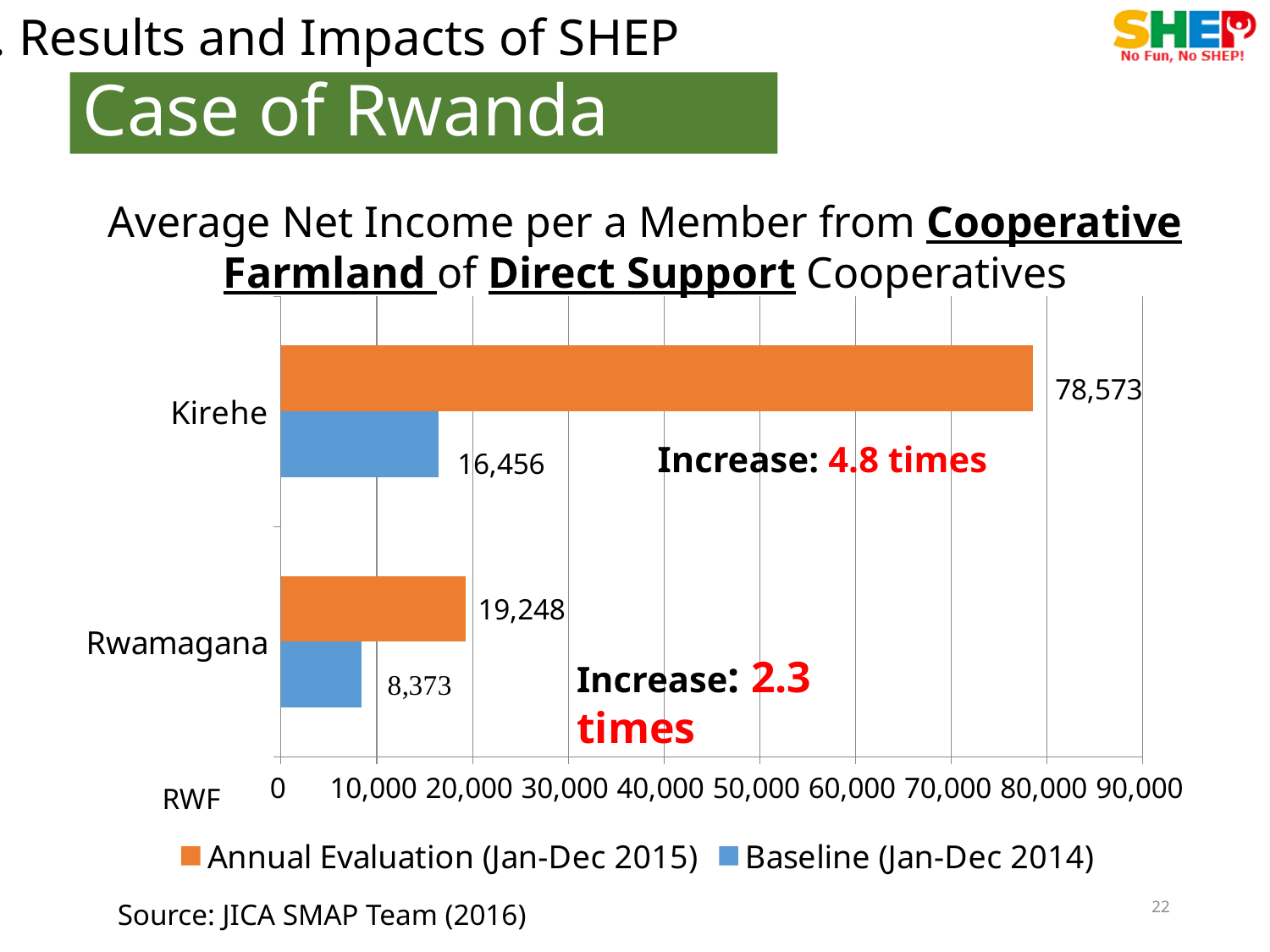
What kind of chart is shown on the slide? Bar chart What is the Annual Evaluation (Jan-Dec 2015) value for Rwamagana? 19,248 What is the Annual Evaluation (Jan-Dec 2015) value for Kirehe? 78,573 How many series does the legend list? 2 Which is larger: the Baseline (Jan-Dec 2014) value for Kirehe or the Annual Evaluation (Jan-Dec 2015) value for Rwamagana? Annual Evaluation (Jan-Dec 2015) value for Rwamagana How many categories are shown on the chart? 2 What is the Baseline (Jan-Dec 2014) value for Rwamagana? 8,373 What is the difference between the Annual Evaluation (Jan-Dec 2015) and Baseline (Jan-Dec 2014) values for Kirehe? 62,117 What is the Baseline (Jan-Dec 2014) value for Kirehe? 16,456 What is the difference between the Annual Evaluation (Jan-Dec 2015) values for Kirehe and Rwamagana? 59,325 Which category has the highest Annual Evaluation (Jan-Dec 2015) value? Kirehe Which category has the lowest Baseline (Jan-Dec 2014) value? Rwamagana